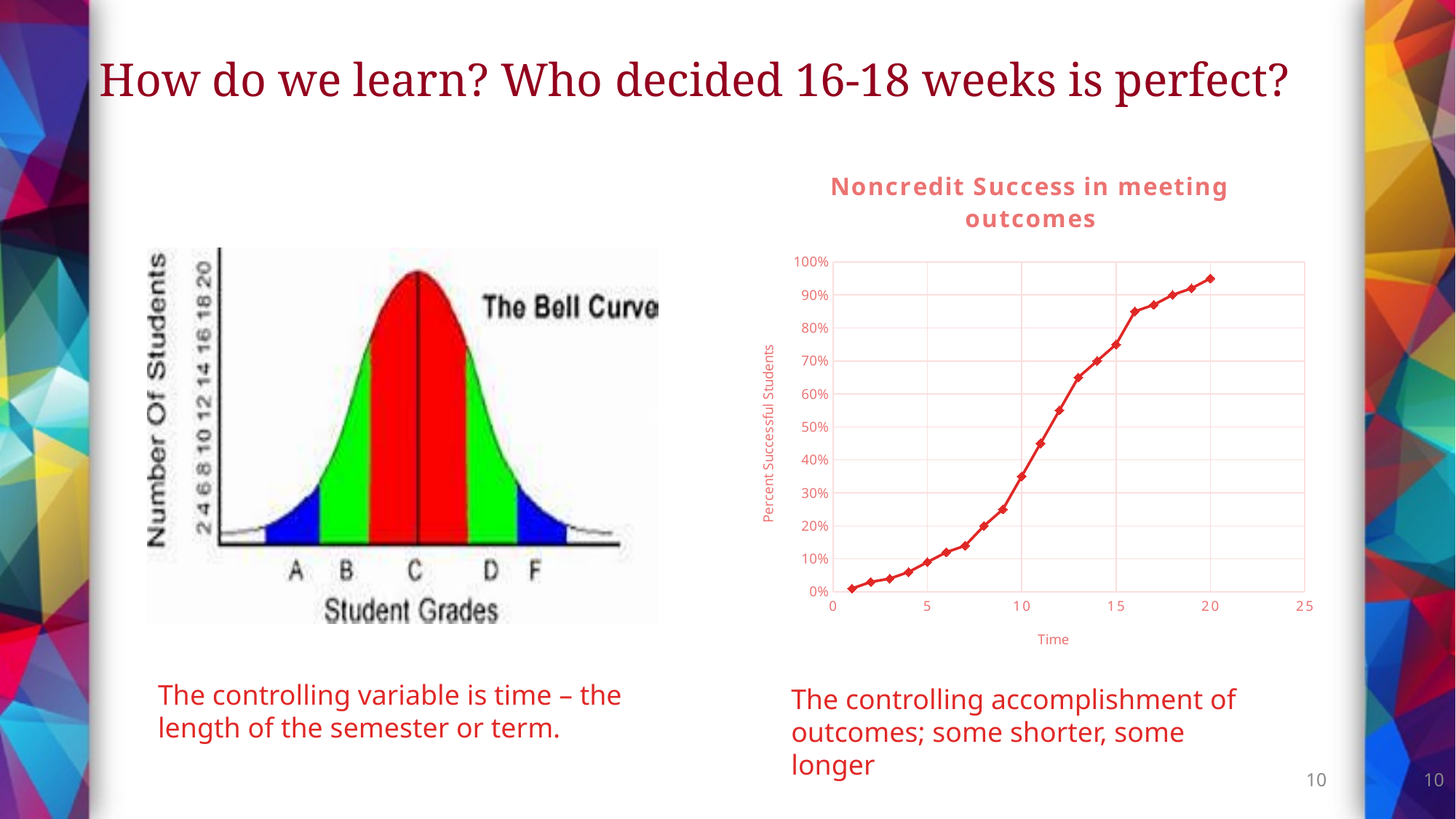
In the 'Noncredit Success in meeting outcomes' chart, is the value at Time 10 greater or less than 30%? greater What is the x-axis label of the 'Noncredit Success in meeting outcomes' chart? Time In the 'Noncredit Success in meeting outcomes' chart, do the values rise or fall as Time increases? rise How many data points are plotted in the 'Noncredit Success in meeting outcomes' chart? 20 In the 'Noncredit Success in meeting outcomes' chart, which has the higher value: Time 12 or Time 8? Time 12 In the 'Noncredit Success in meeting outcomes' chart, is the value at Time 20 greater or less than 100%? less In the 'The Bell Curve' chart on the left, which student grade has the highest number of students? C In the 'Noncredit Success in meeting outcomes' chart, is the value at Time 5 greater or less than 20%? less What kind of chart is the 'Noncredit Success in meeting outcomes' chart? line chart What is the y-axis label of the 'Noncredit Success in meeting outcomes' chart? Percent Successful Students How many student grade categories are shown on the x-axis of 'The Bell Curve' chart on the left? 5